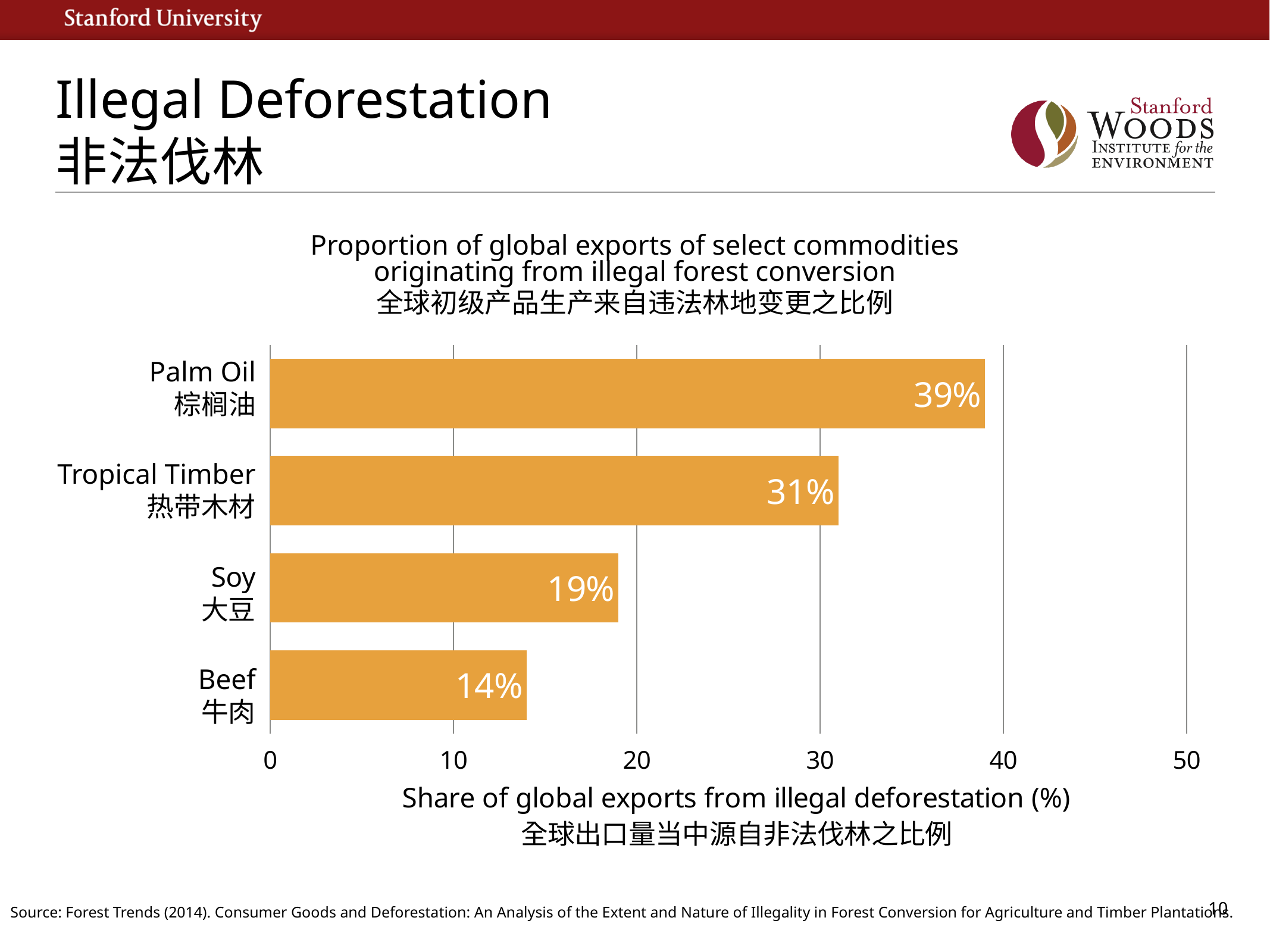
How many commodities are shown in the chart? 4 What is the difference between the values for Palm Oil and Beef? 25% Is the value for Tropical Timber greater or less than 40? less What kind of chart is shown on the slide? bar chart Which commodity has the highest share of global exports from illegal deforestation? Palm Oil Which commodity has the lowest share of global exports from illegal deforestation? Beef Which is larger, the value for Soy or the value for Beef? Soy What is the value for Soy? 19% What is the value for Tropical Timber? 31% What is the difference between the values for Tropical Timber and Soy? 12% What is the value for Palm Oil? 39% What is the value for Beef? 14%